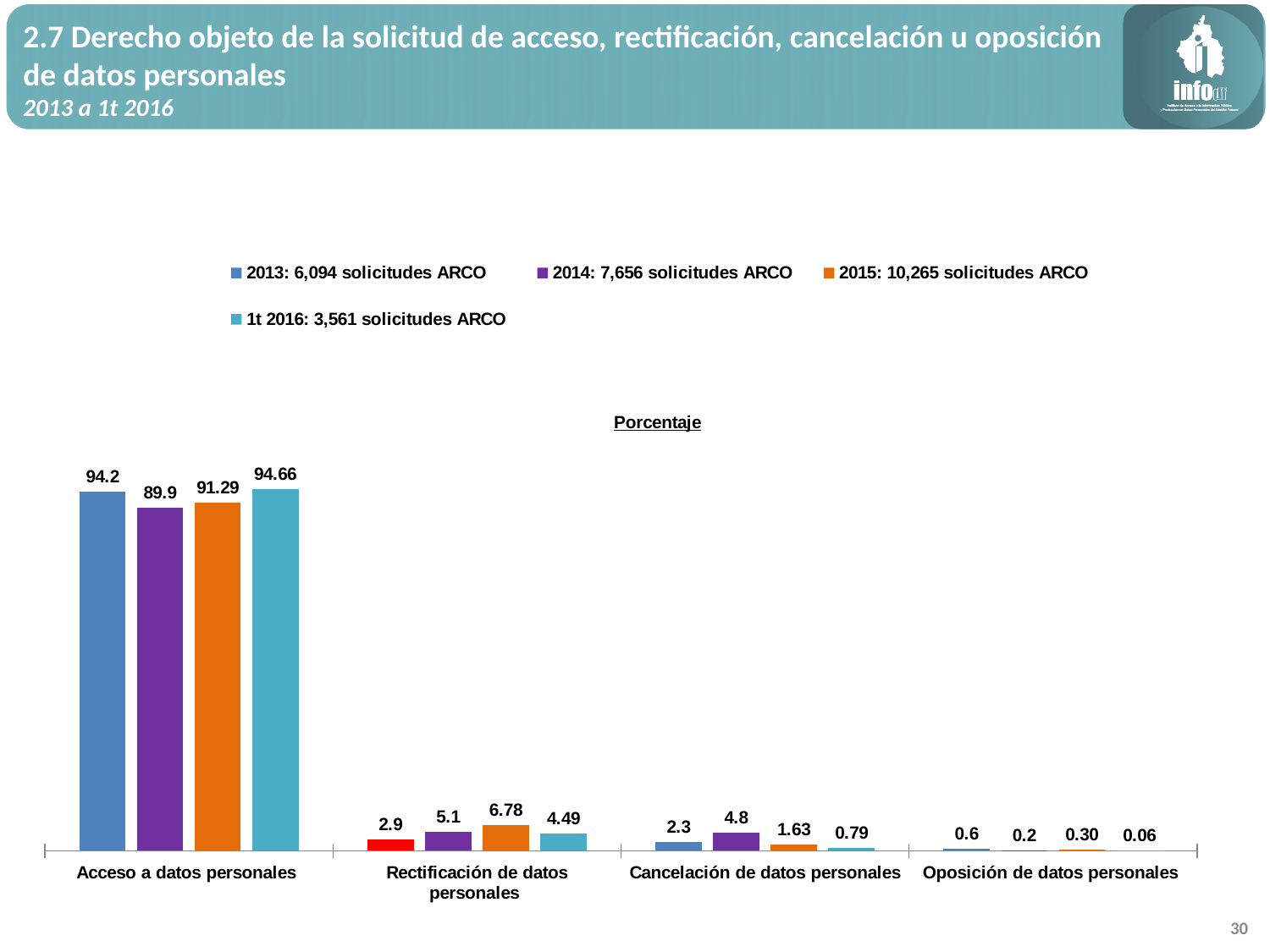
How many series does the legend list? 4 What is the difference between the 2015 and 2013 values in the Rectificación de datos personales category? 3.88 What is the value for 2015 in the Rectificación de datos personales category? 6.78 How many categories are shown on the x axis? 4 Which is larger in the Cancelación de datos personales category: the 2014 value or the 2015 value? 2014 Which series has the highest value in the Acceso a datos personales category? 1t 2016: 3,561 solicitudes ARCO What is the value for 2014 in the Oposición de datos personales category? 0.2 What is the title printed above the chart? Porcentaje What is the value for 2013 in the Acceso a datos personales category? 94.2 Which series has the lowest value in the Oposición de datos personales category? 1t 2016: 3,561 solicitudes ARCO What is the value for 1t 2016 in the Cancelación de datos personales category? 0.79 What kind of chart is shown on the slide? Bar chart